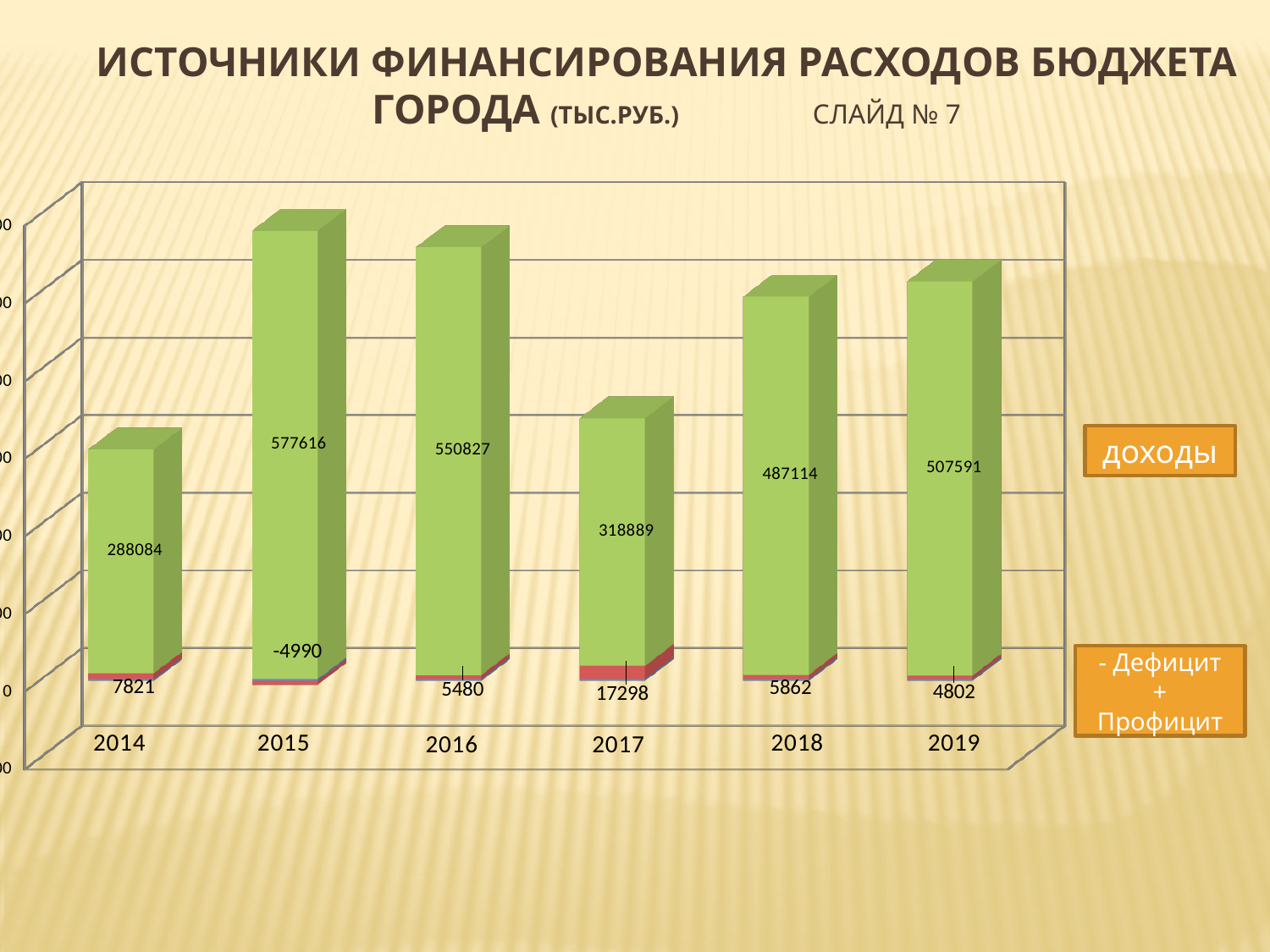
Which year has the larger ДОХОДЫ value, 2016 or 2017? 2016 How many series does the legend list? 2 What is the ДОХОДЫ value for 2017? 318889 How many years are shown on the x axis? 6 What is the Дефицит/Профицит value for 2015? -4990 Which year has the highest ДОХОДЫ value? 2015 What is the difference between the ДОХОДЫ values for 2019 and 2018? 20477 What is the Дефицит/Профицит value for 2014? 7821 What kind of chart is shown on the slide? bar chart Which year has the lowest ДОХОДЫ value? 2014 What is the unit given in the chart title? тыс.руб. What is the ДОХОДЫ value for 2015? 577616